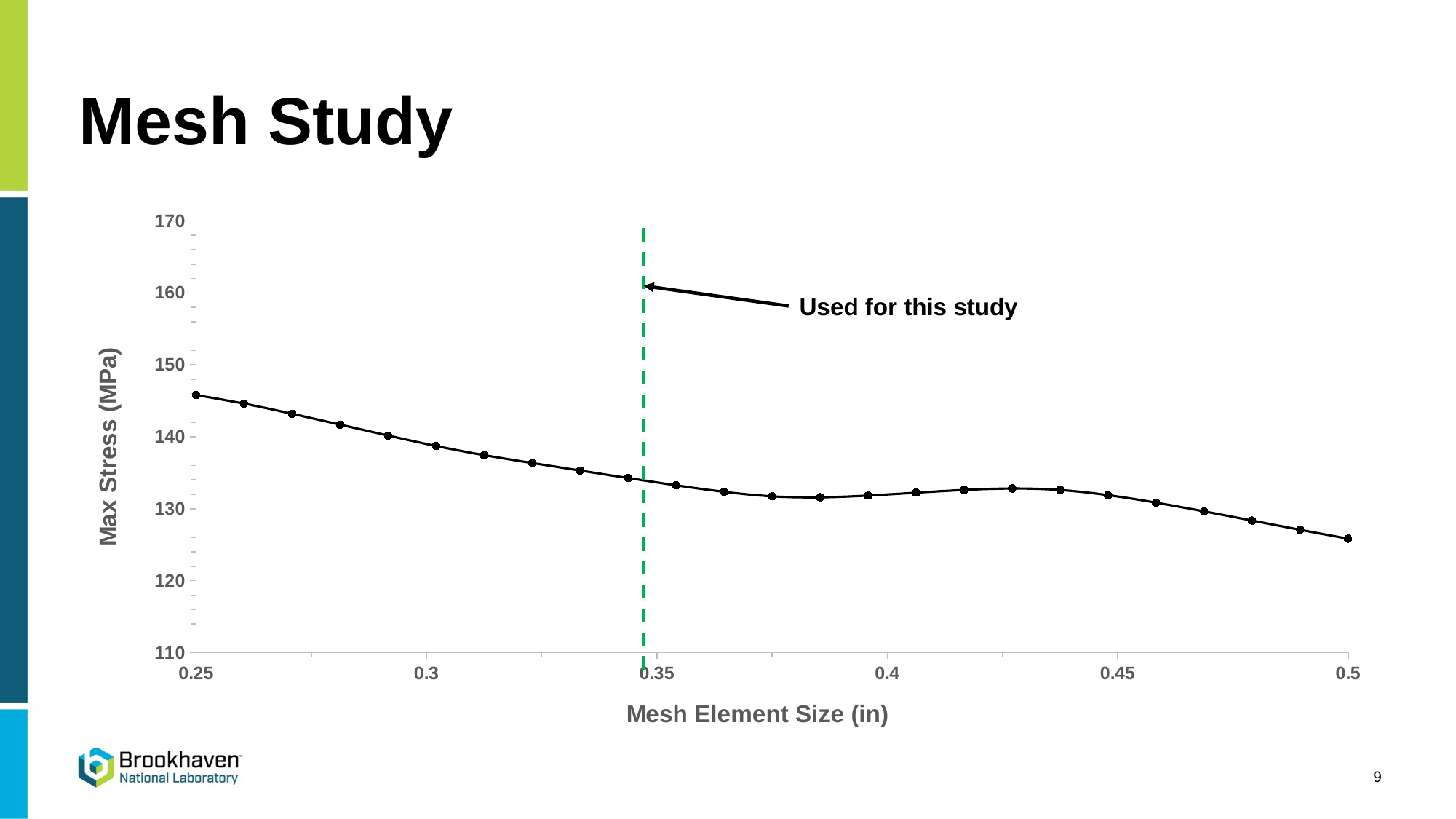
What is the title of the chart's y axis? Max Stress (MPa) At which mesh element size is the max stress lowest? 0.5 At which mesh element size is the max stress highest? 0.25 Which has the larger max stress: a mesh element size of 0.3 or 0.45? 0.3 What is the title of the chart's x axis? Mesh Element Size (in) Is the max stress at a mesh element size of 0.3 greater or less than 130? greater What kind of chart is shown on the slide? line chart Is the max stress at a mesh element size of 0.4 greater or less than 140? less Which has the larger max stress: a mesh element size of 0.25 or 0.5? 0.25 Overall, does the max stress rise or fall as the mesh element size increases from 0.25 to 0.5? fall Is the max stress at a mesh element size of 0.25 greater or less than 140? greater